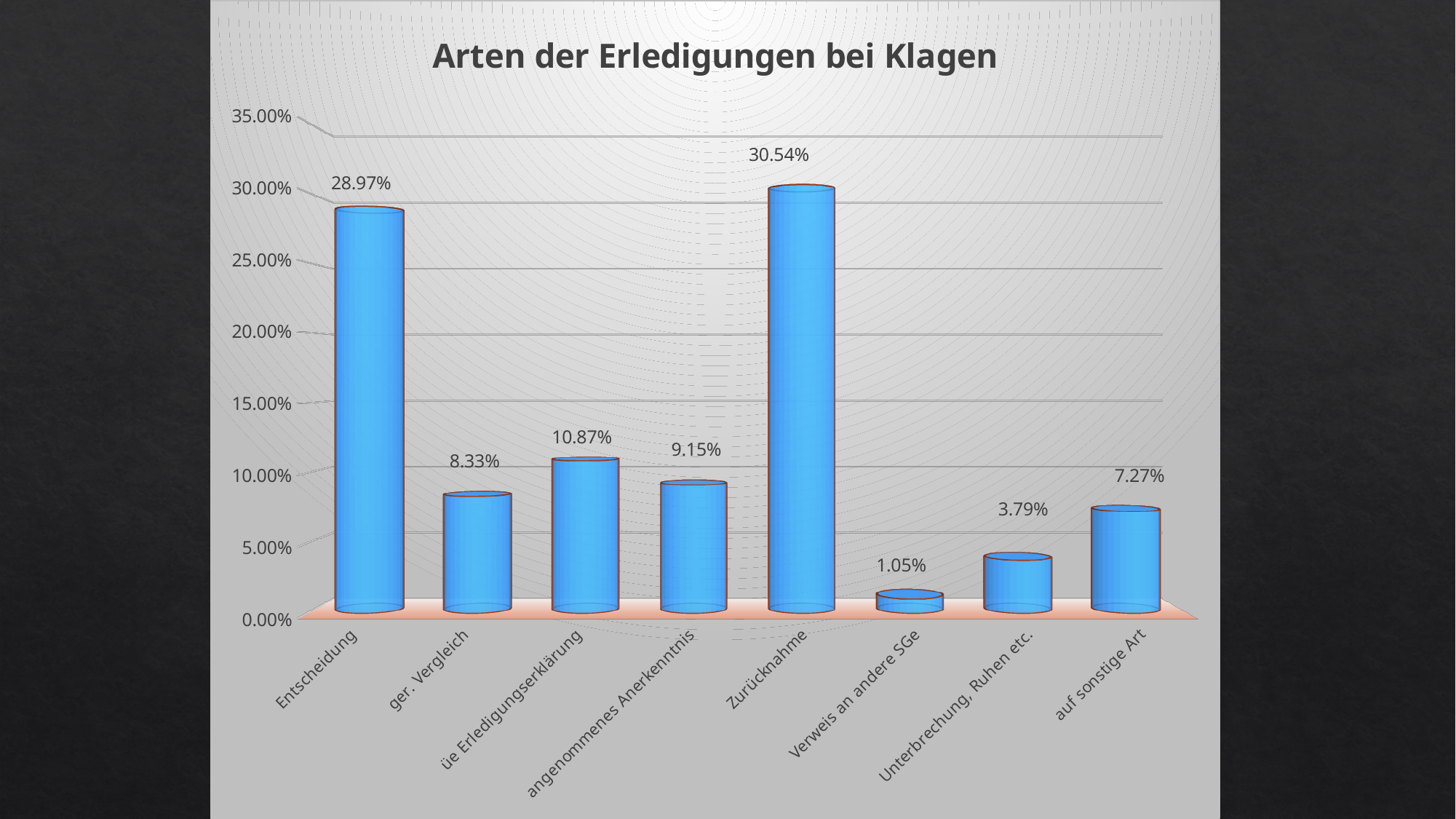
Which is larger, angenommenes Anerkenntnis or ger. Vergleich? angenommenes Anerkenntnis What is the difference between Zurücknahme and Entscheidung? 1.57% What is the value for Verweis an andere SGe? 1.05% Which category has the lowest value? Verweis an andere SGe How many categories are shown on the chart? 8 What is the value for Zurücknahme? 30.54% What is the title of the chart? Arten der Erledigungen bei Klagen What is the value for auf sonstige Art? 7.27% Is the value for Unterbrechung, Ruhen etc. greater or less than 5.00%? less What is the difference between üe Erledigungserklärung and ger. Vergleich? 2.54% Which category has the highest value? Zurücknahme What is the value for Entscheidung? 28.97%